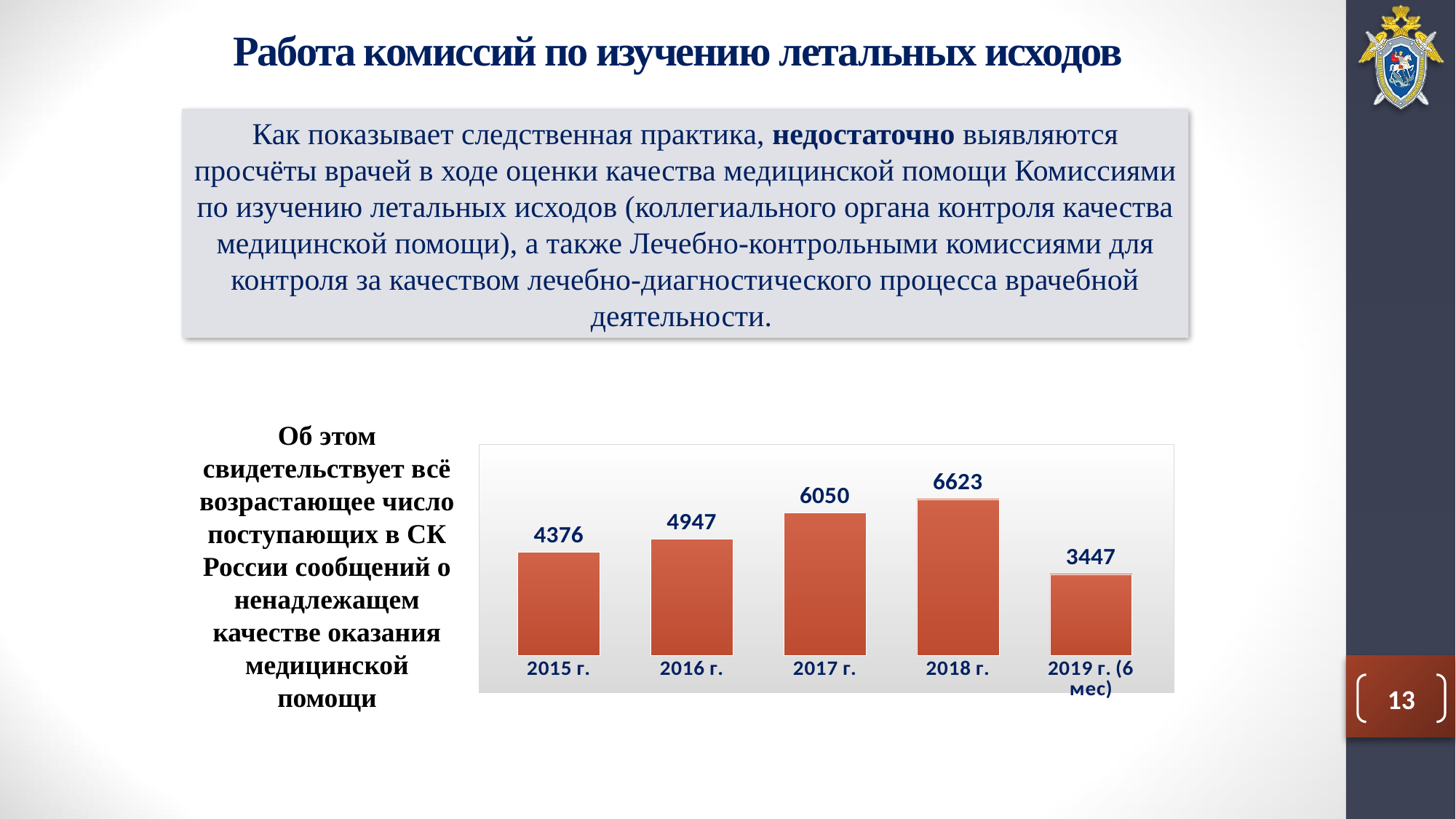
Which category has the lowest value? 2019 г. (6 мес) What is the value shown for 2017 г.? 6050 Which is larger, the value for 2016 г. or the value for 2019 г. (6 мес)? 2016 г. Which category has the highest value? 2018 г. What colour are the bars in the chart? orange-red What kind of chart is shown on the slide? bar chart How many categories are shown on the x axis? 5 What is the difference between the values for 2018 г. and 2017 г.? 573 What is the value shown for 2015 г.? 4376 Do the values rise or fall from 2015 г. to 2018 г.? rise What is the difference between the values for 2016 г. and 2015 г.? 571 What is the value shown for 2019 г. (6 мес)? 3447